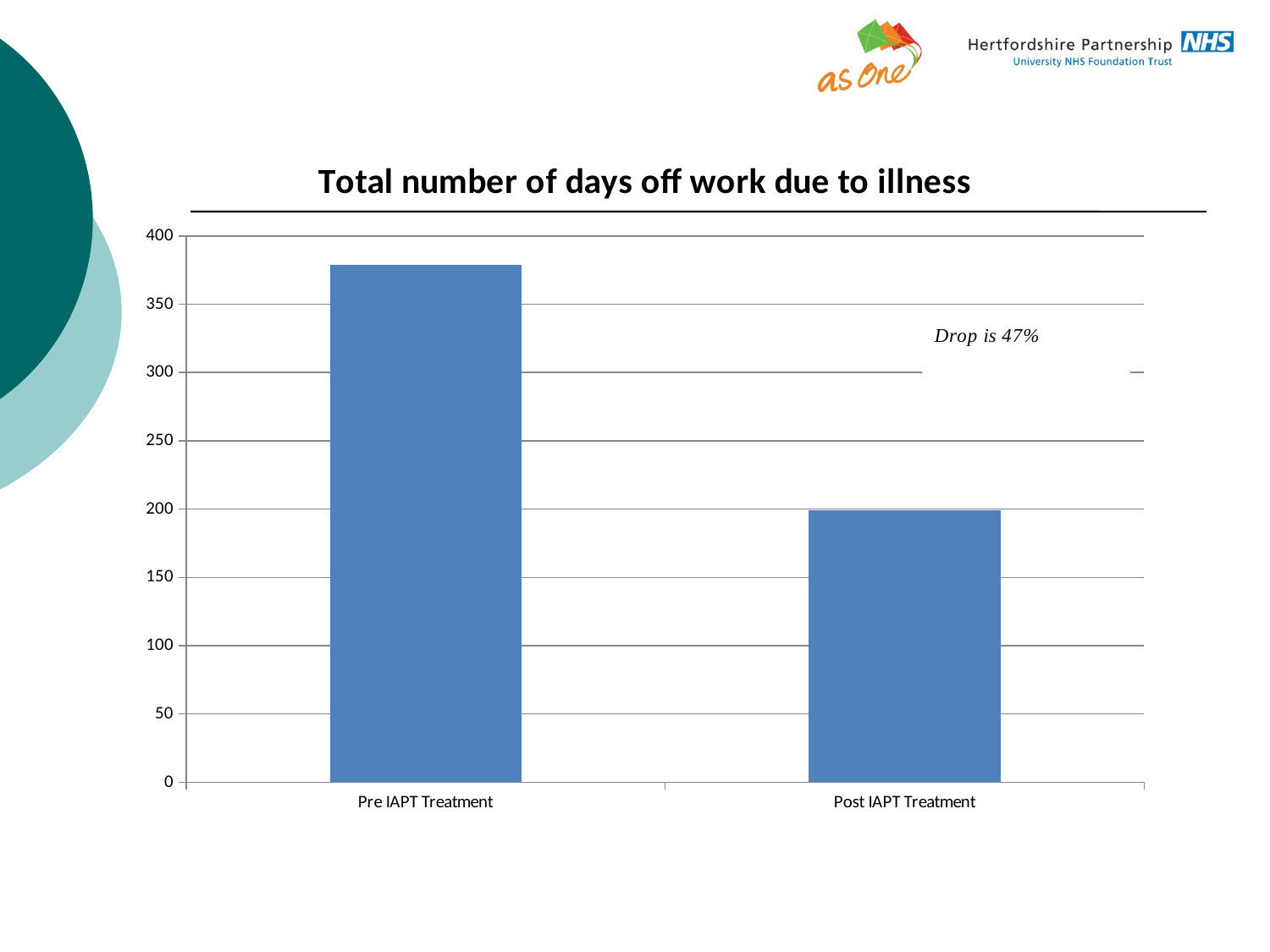
Is the value for Pre IAPT Treatment greater or less than 350? greater What type of chart is shown on the slide? bar chart Is the value for Pre IAPT Treatment greater or less than 400? less Is the value for Post IAPT Treatment greater or less than 150? greater What is the title of the chart? Total number of days off work due to illness Do the values rise or fall from Pre IAPT Treatment to Post IAPT Treatment? fall What percentage drop does the annotation on the chart state? 47% Which category has the lowest total number of days off work? Post IAPT Treatment Which is larger, the value for Pre IAPT Treatment or Post IAPT Treatment? Pre IAPT Treatment Which category has the highest total number of days off work? Pre IAPT Treatment How many categories are plotted on the x axis? 2